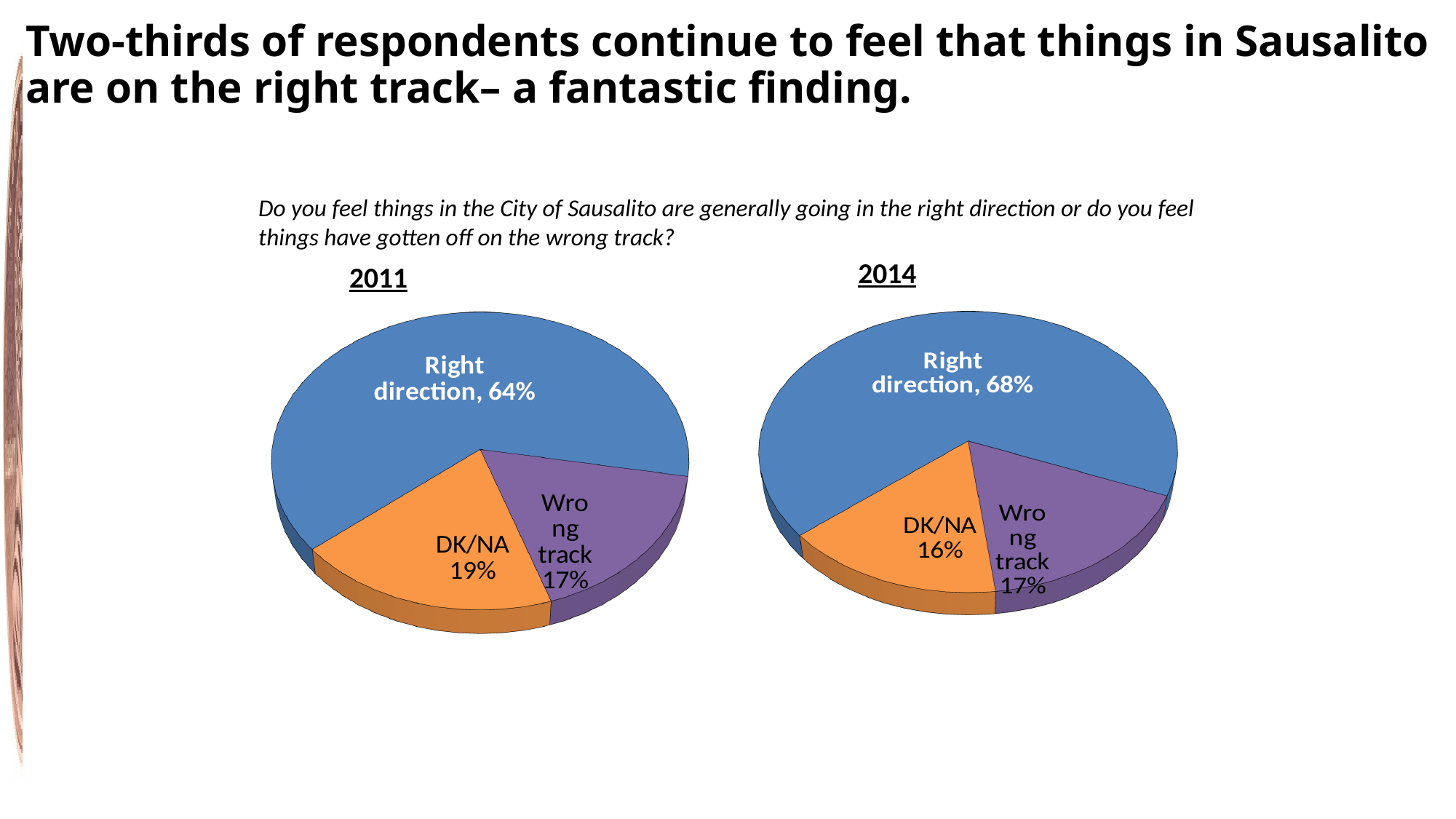
In the 2011 pie chart, which is larger, DK/NA or Wrong track? DK/NA How many slices does the 2014 pie chart have? 3 What type of chart is used to show the 2011 results? Pie chart In the 2014 pie chart, which category has the smallest slice? DK/NA In the 2011 pie chart, which category has the largest slice? Right direction In the 2011 pie chart, what is the difference between the Right direction and Wrong track shares? 47 percentage points What colour is the Wrong track slice in both pie charts? Purple In the 2014 pie chart, what is the value for Wrong track? 17% What is the difference between the Right direction share in 2014 and in 2011? 4 percentage points In the 2011 pie chart, what is the value for DK/NA? 19% In the 2011 pie chart, what share of respondents said Right direction? 64% In the 2014 pie chart, what share of respondents said Right direction? 68%